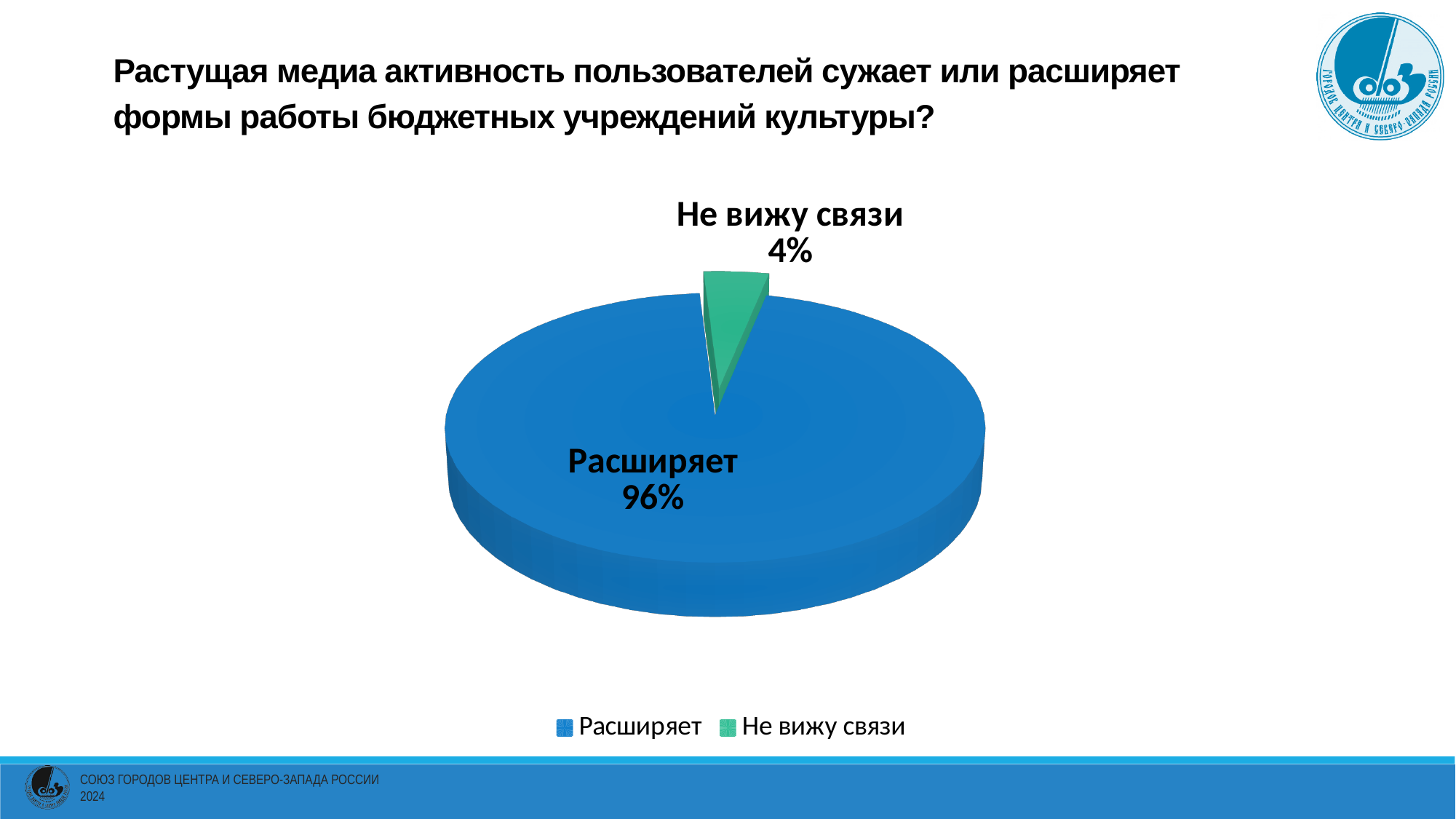
How many categories does the pie chart show? 2 What is the difference in percentage points between "Расширяет" and "Не вижу связи"? 92 Which category has the largest slice of the pie? Расширяет How many entries does the legend list? 2 What share of the pie does "Не вижу связи" take? 4% What colour is the slice for "Не вижу связи"? Green What colour is the slice for "Расширяет"? Blue Which is larger: the share for "Расширяет" or the share for "Не вижу связи"? Расширяет What kind of chart is shown on the slide? Pie chart Which category has the smallest slice of the pie? Не вижу связи What share of the pie does "Расширяет" take? 96%